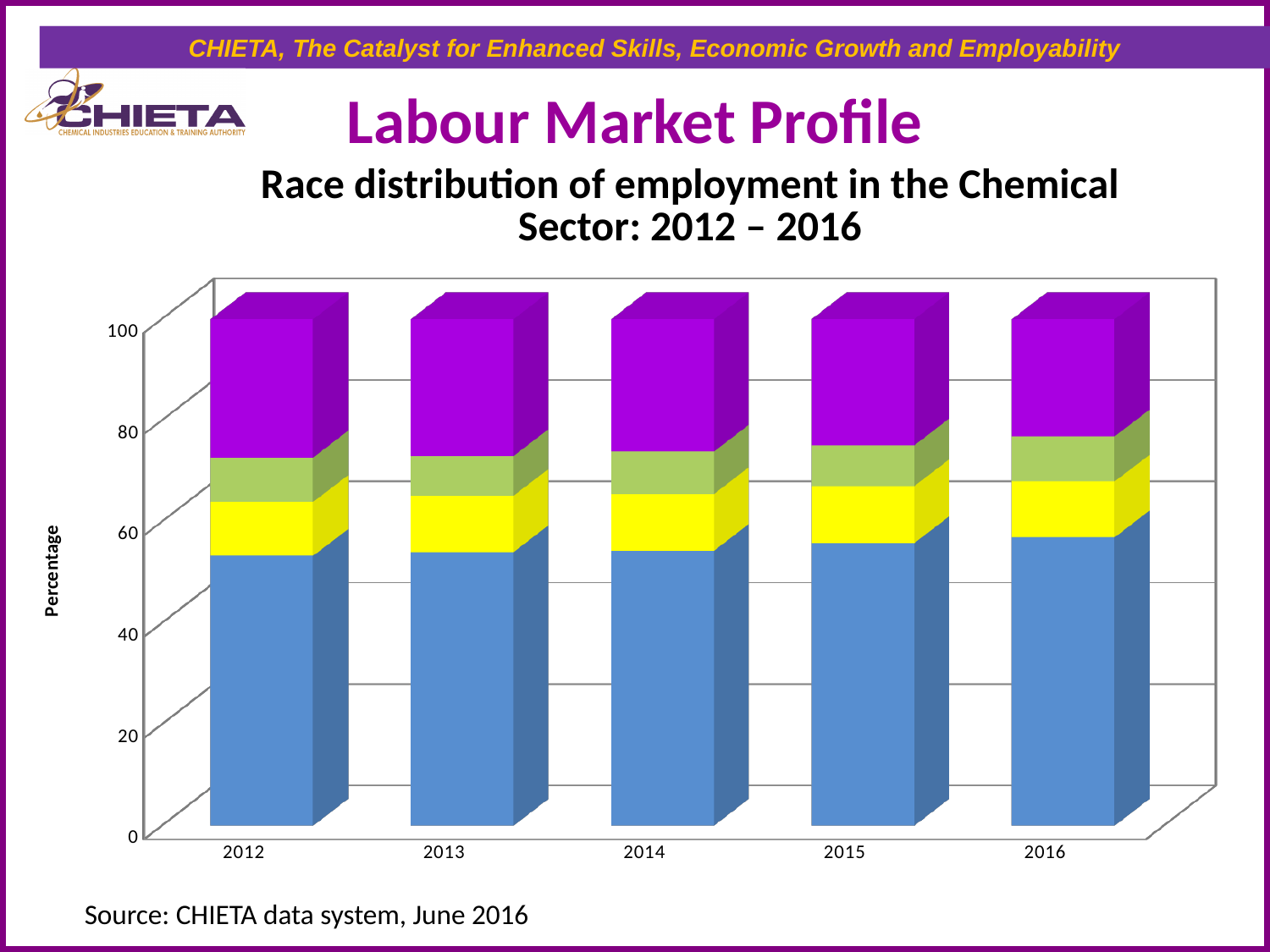
How many years are shown along the x axis of the chart? 5 Is the value of the blue (bottom) segment for 2016 greater or less than 40? greater What is the label on the vertical axis of the chart? Percentage What is the total height of the stacked bar for 2012? 100 What kind of chart is shown on the slide? Stacked bar chart What is the title of the chart? Race distribution of employment in the Chemical Sector: 2012 – 2016 Is the value of the blue (bottom) segment for 2012 greater or less than 60? less Does the blue (bottom) segment rise or fall from 2012 to 2016? Rises Which year has the larger purple (top) segment, 2012 or 2016? 2012 Is the value of the purple (top) segment for 2012 greater or less than 20? greater Which year has the larger blue (bottom) segment, 2012 or 2016? 2016 Which year has the smallest blue (bottom) segment? 2012